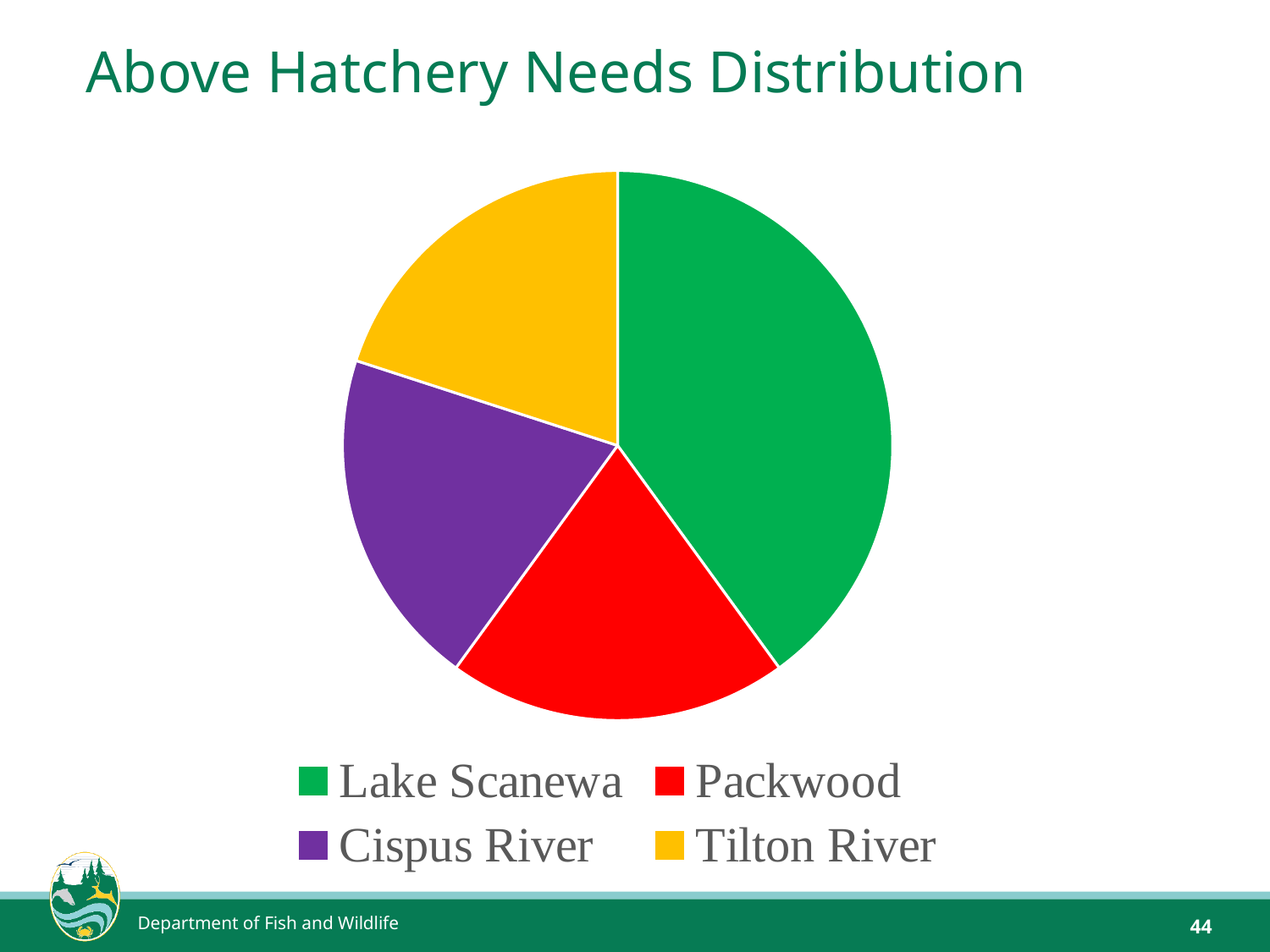
Which category has the largest slice of the pie? Lake Scanewa Which is larger, the slice for Lake Scanewa or the slice for Packwood? Lake Scanewa Which is larger, the slice for Lake Scanewa or the slice for Tilton River? Lake Scanewa How many entries does the legend list? 4 What colour is the slice for Cispus River? purple What is the title of the chart? Above Hatchery Needs Distribution What kind of chart is shown on the slide? pie chart How many slices does the pie chart have? 4